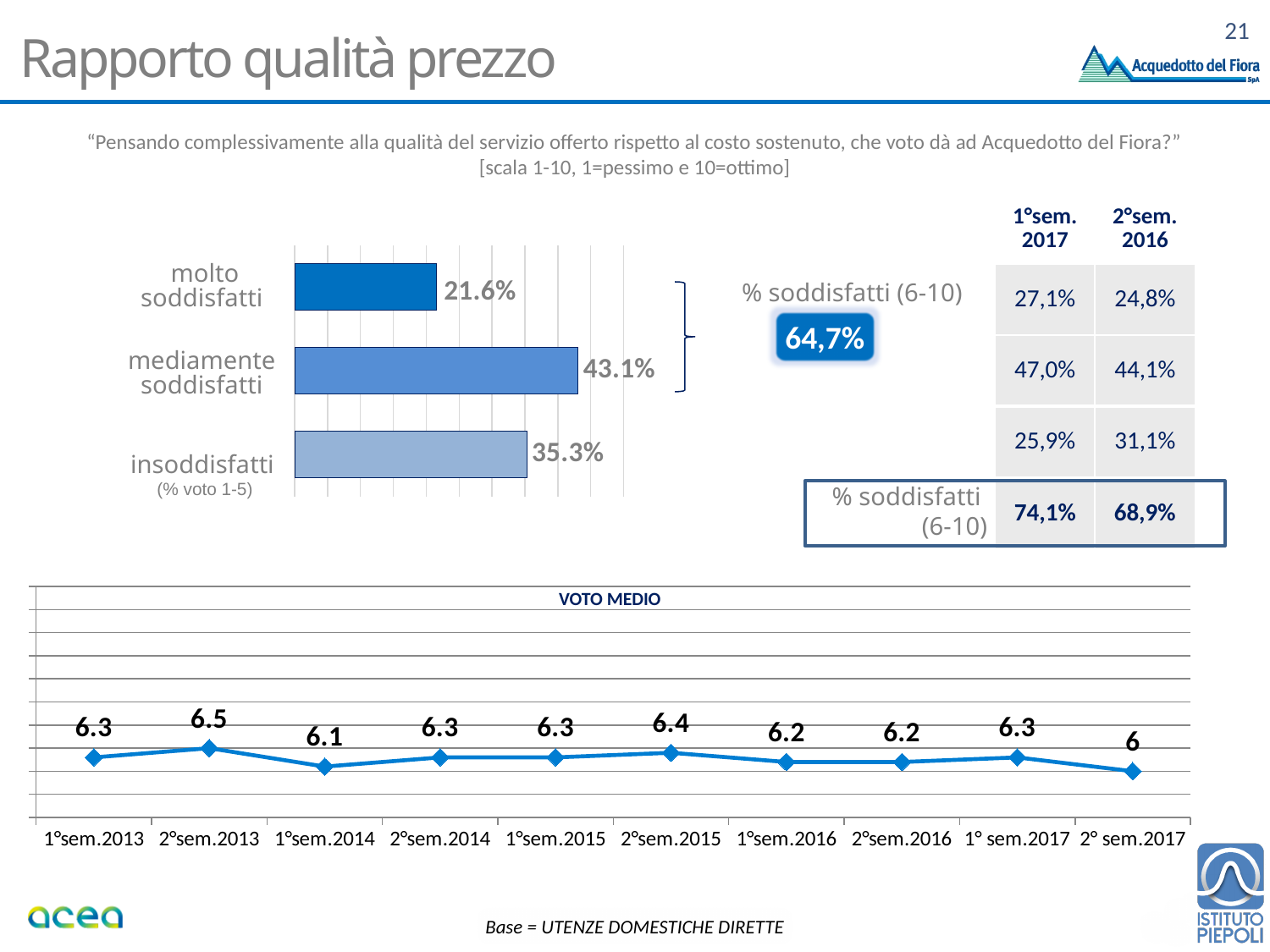
What kind of chart is the 'VOTO MEDIO' chart at the bottom of the slide? line chart In the bar chart at the top left, how many categories are shown? 3 In the 'VOTO MEDIO' chart, how many data points are plotted? 10 In the 'VOTO MEDIO' chart, what is the value for 2°sem.2013? 6.5 In the bar chart at the top left, which category has the highest value? mediamente soddisfatti In the bar chart at the top left, what is the value for 'insoddisfatti'? 35.3% In the 'VOTO MEDIO' chart, which period has the lowest value? 2° sem.2017 In the bar chart at the top left, what is the value for 'mediamente soddisfatti'? 43.1% In the bar chart at the top left, what is the difference between 'mediamente soddisfatti' and 'molto soddisfatti'? 21.5% In the bar chart at the top left, which category has the lowest value? molto soddisfatti In the 'VOTO MEDIO' chart, what is the value for 2° sem.2017? 6 In the 'VOTO MEDIO' chart, is the value for 1°sem.2014 larger or smaller than the value for 2°sem.2015? smaller